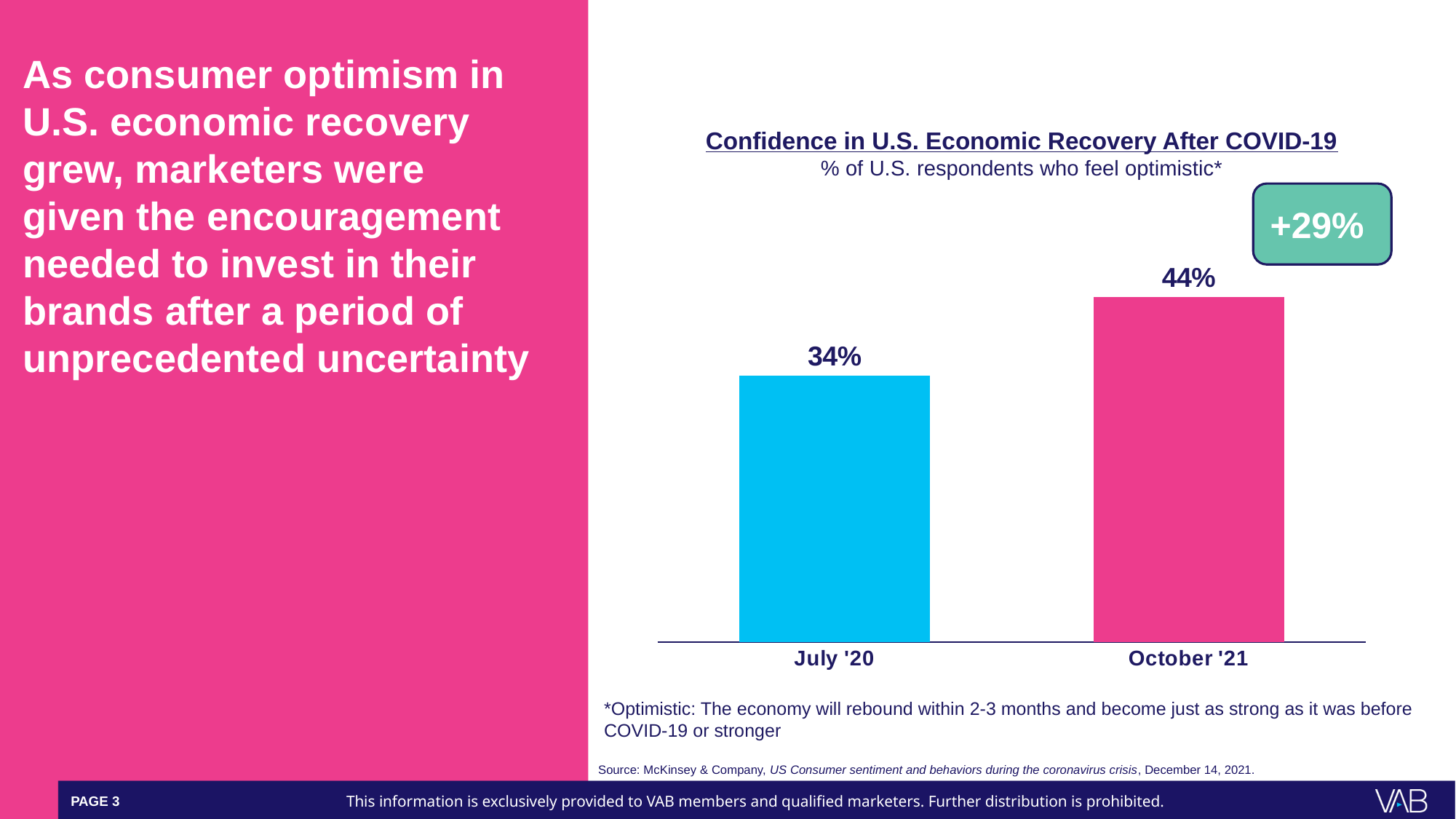
Which category has the lowest value? July '20 Which category has the highest value? October '21 What is the value for July '20? 34% What is the value for October '21? 44% What percentage change is shown in the callout box above the October '21 bar? +29% Do the values rise or fall from July '20 to October '21? Rise What is the title of the chart? Confidence in U.S. Economic Recovery After COVID-19 Which is larger, the value for July '20 or the value for October '21? October '21 What is the difference in percentage points between October '21 and July '20? 10 percentage points What kind of chart is shown? Bar chart How many categories are shown on the x axis? 2